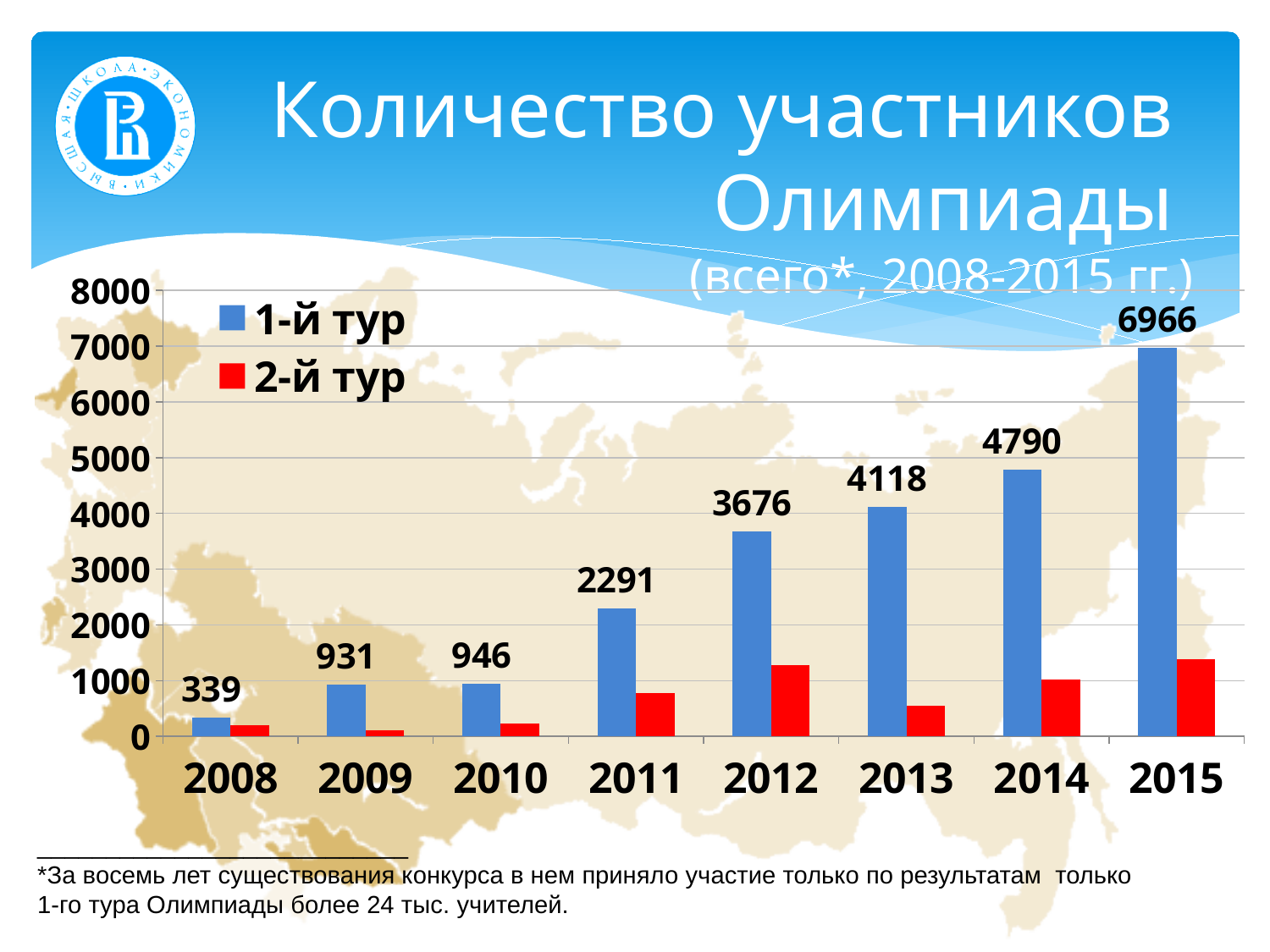
What kind of chart is shown on the slide? bar chart How many years are shown on the x axis? 8 What is the value for 1-й тур in 2012? 3676 How many series does the legend list? 2 What is the value for 1-й тур in 2008? 339 Which year has the highest value for 1-й тур? 2015 Is the value for 2-й тур in 2009 greater or less than 500? less Is the value for 2-й тур in 2012 greater or less than 1000? greater What is the difference between the 1-й тур values for 2015 and 2014? 2176 What is the value for 1-й тур in 2015? 6966 Which is larger for 1-й тур: 2010 or 2011? 2011 Which year has the lowest value for 1-й тур? 2008